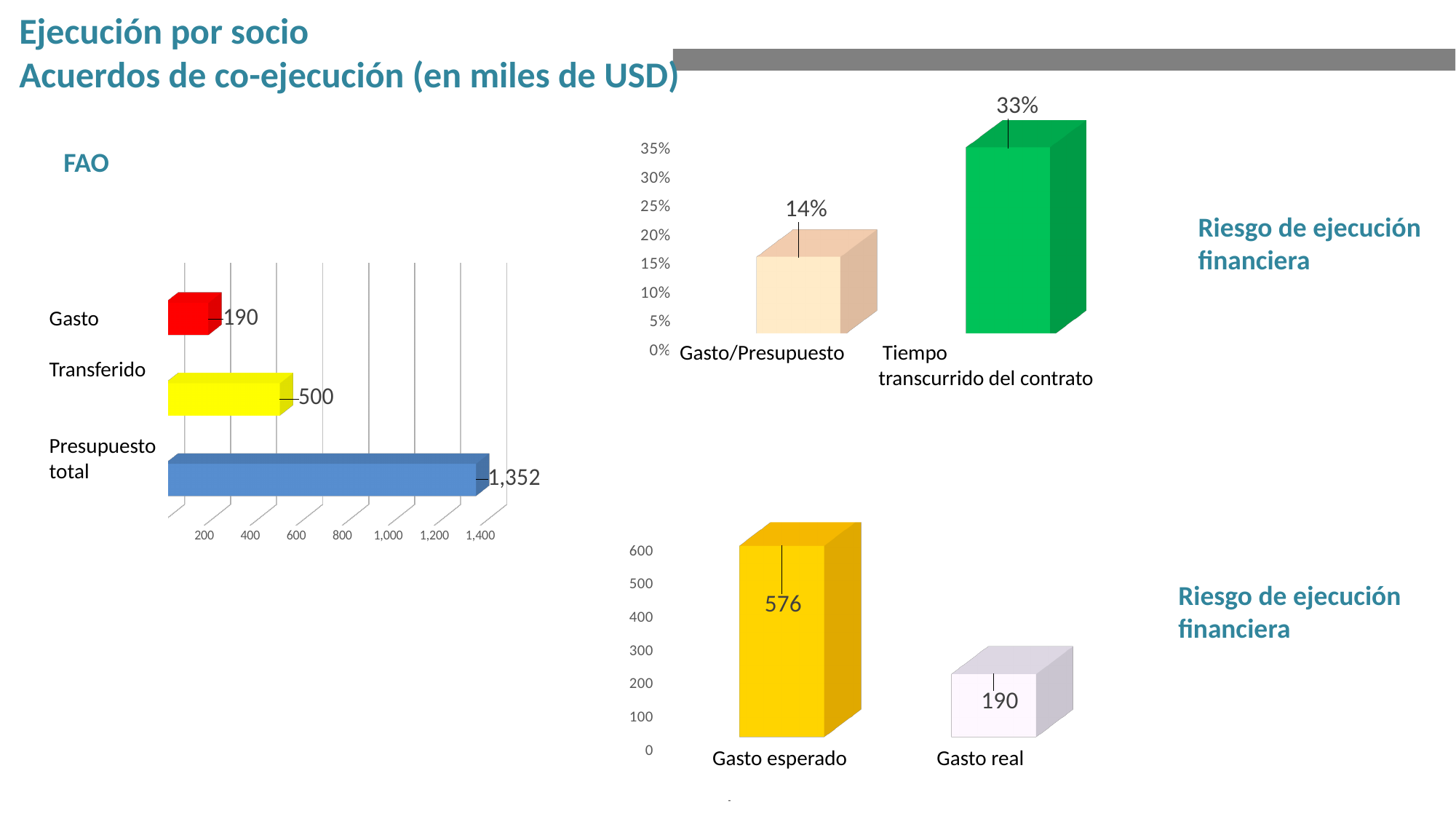
In the FAO chart on the left, what is the value for Gasto? 190 In the FAO chart on the left, what is the value for Transferido? 500 In the top-right chart, what is the value for Tiempo transcurrido del contrato? 33% In the bottom-right chart, what is the difference between Gasto esperado and Gasto real? 386 In the FAO chart on the left, what is the difference between Transferido and Gasto? 310 In the FAO chart on the left, what is the value for Presupuesto total? 1,352 In the top-right chart, what is the value for Gasto/Presupuesto? 14% What kind of chart is the FAO chart on the left? Bar chart In the FAO chart on the left, how many categories are plotted? 3 In the FAO chart on the left, which category has the lowest value? Gasto In the bottom-right chart, what is the value for Gasto esperado? 576 In the FAO chart on the left, which category has the highest value? Presupuesto total